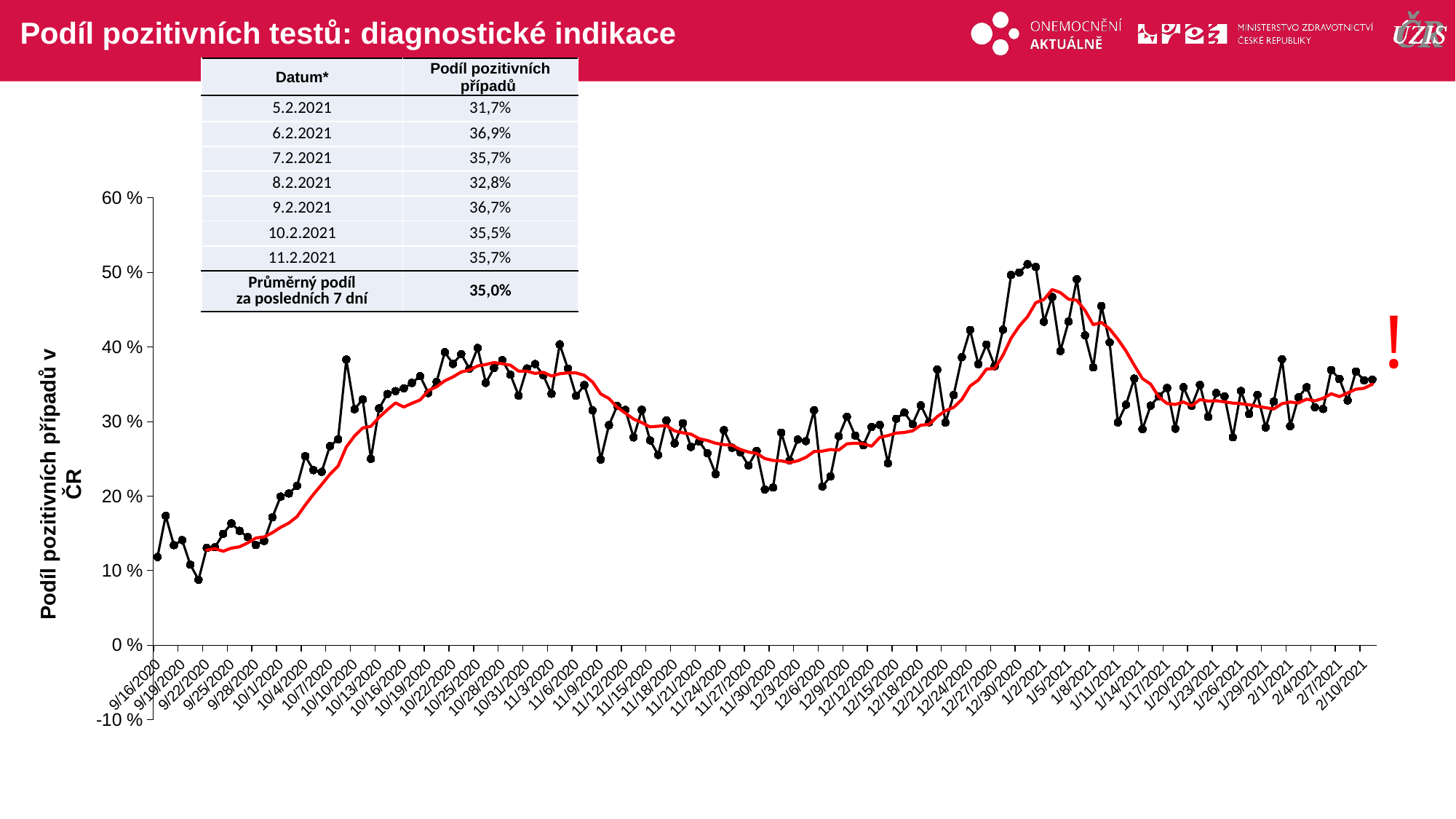
What is the label of the vertical axis of the chart? Podíl pozitivních případů v ČR Is the share of positive cases on 8.2.2021 in the table greater or less than that on 9.2.2021? less Among the dates listed in the table, which date has the lowest share of positive cases? 5.2.2021 What is the title of the slide containing the chart? Podíl pozitivních testů: diagnostické indikace What is the difference between the share of positive cases on 6.2.2021 and on 5.2.2021 in the table? 5,2% What kind of chart is shown on the slide? line chart Among the dates listed in the table, which date has the highest share of positive cases? 6.2.2021 Does the black line rise or fall between 9/16/2020 and 10/25/2020? rise According to the table on the slide, what is the share of positive cases on 6.2.2021? 36,9% According to the table on the slide, what is the average share over the last 7 days (Průměrný podíl za posledních 7 dní)? 35,0% According to the table on the slide, what is the share of positive cases (Podíl pozitivních případů) on 5.2.2021? 31,7%